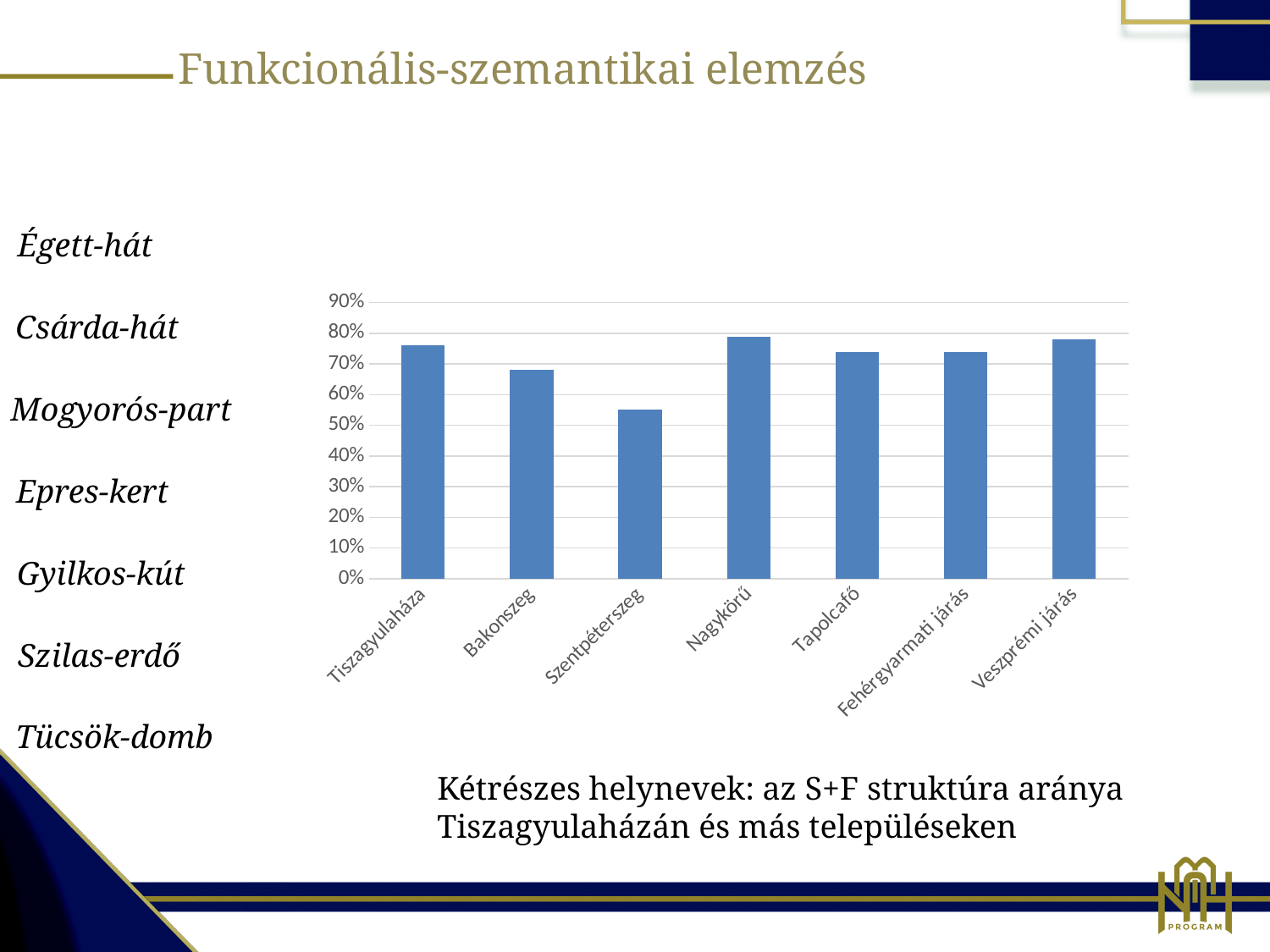
How many categories (settlements/districts) are shown on the x axis of the chart? 7 Which category has the lowest value in the chart? Szentpéterszeg Is the value for Veszprémi járás greater or less than 70%? greater What is the highest tick value shown on the vertical axis of the chart? 90% Is the value for Bakonszeg greater or less than 60%? greater Which has the larger value, Bakonszeg or Szentpéterszeg? Bakonszeg What is the first category on the left of the x axis? Tiszagyulaháza Is the value for Szentpéterszeg greater or less than 60%? less What kind of chart is shown on the slide? bar chart Which has the larger value, Tiszagyulaháza or Bakonszeg? Tiszagyulaháza